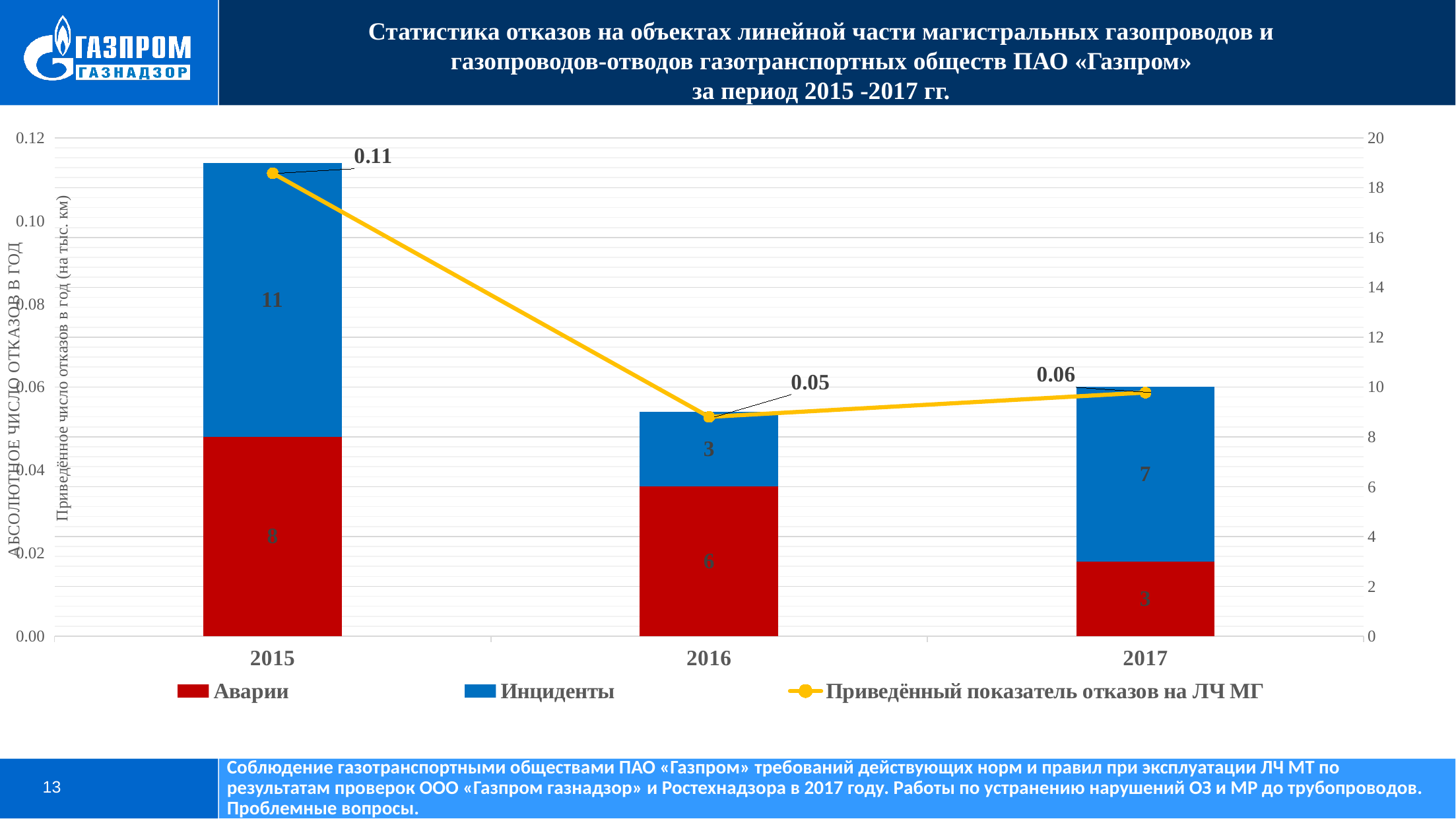
Does the Приведённый показатель отказов на ЛЧ МГ line rise or fall from 2015 to 2016? fall What is the value of Инциденты for 2017? 7 What is the value of Аварии for 2015? 8 What is the total of the stacked bar for 2015? 19 What is the value of Приведённый показатель отказов на ЛЧ МГ for 2016? 0.05 What is the difference between the Инциденты values for 2015 and 2016? 8 In which year is the Аварии value lowest? 2017 How many years are shown on the x axis? 3 Which is larger in 2016: Аварии or Инциденты? Аварии How many series does the legend list? 3 What is the total of the stacked bar for 2017? 10 In which year is the Инциденты value highest? 2015